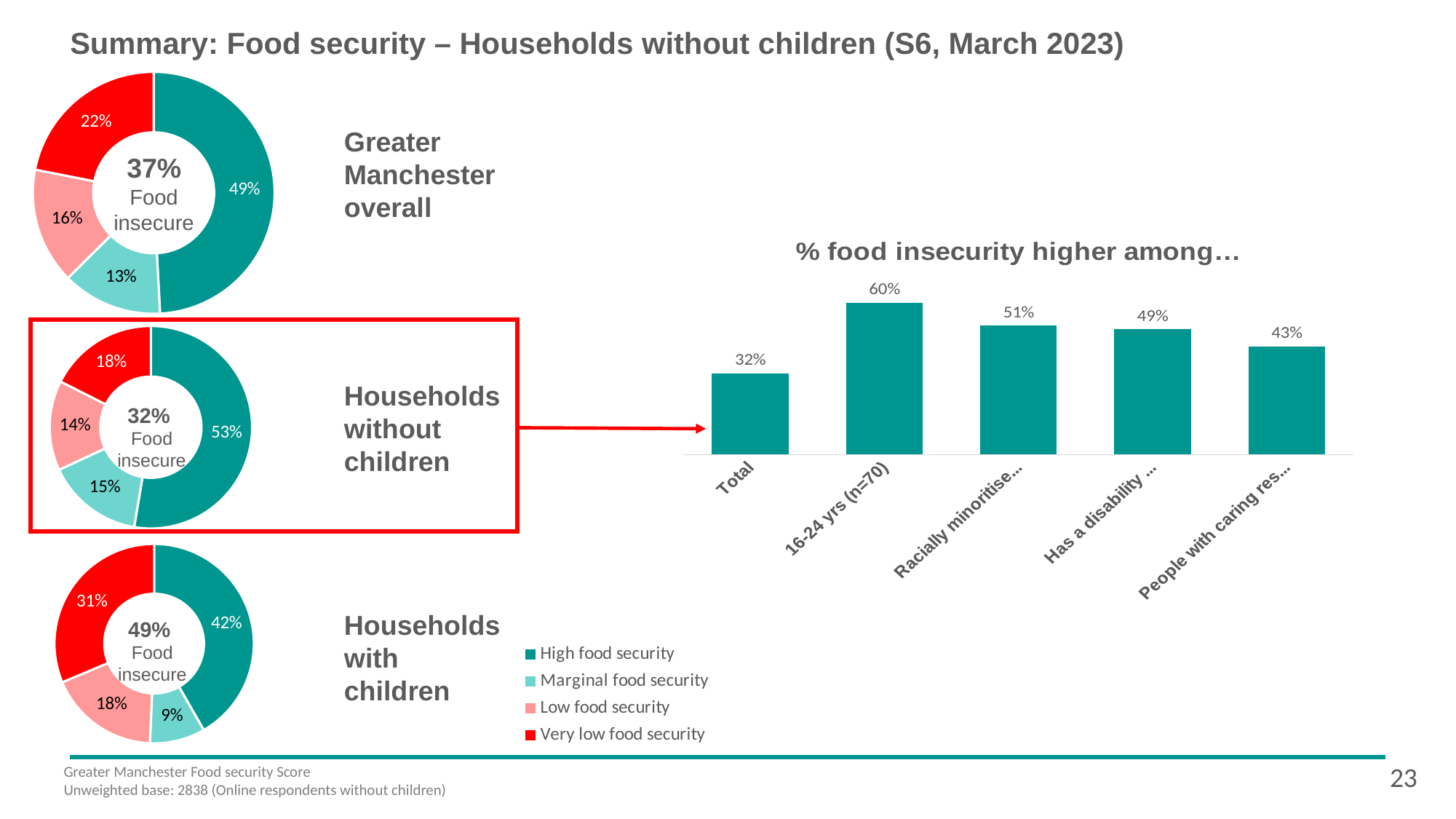
In the 'Greater Manchester overall' donut chart, what share is Marginal food security? 13% In the 'Households without children' donut chart, what share is High food security? 53% How many entries does the legend for the donut charts list? 4 In the '% food insecurity higher among…' bar chart, what is the value for 16-24 yrs (n=70)? 60% In the '% food insecurity higher among…' bar chart, what is the value for Total? 32% What kind of chart is the '% food insecurity higher among…' chart? Bar chart In the '% food insecurity higher among…' bar chart, which category has the highest value? 16-24 yrs (n=70) Which is larger: the Very low food security share in the 'Households with children' donut or in the 'Households without children' donut? Households with children In the '% food insecurity higher among…' bar chart, which category has the lowest value? Total In the 'Households with children' donut chart, what share is Very low food security? 31% In the '% food insecurity higher among…' bar chart, what is the difference between the 16-24 yrs (n=70) value and the Total value? 28% How many bars are in the '% food insecurity higher among…' bar chart? 5